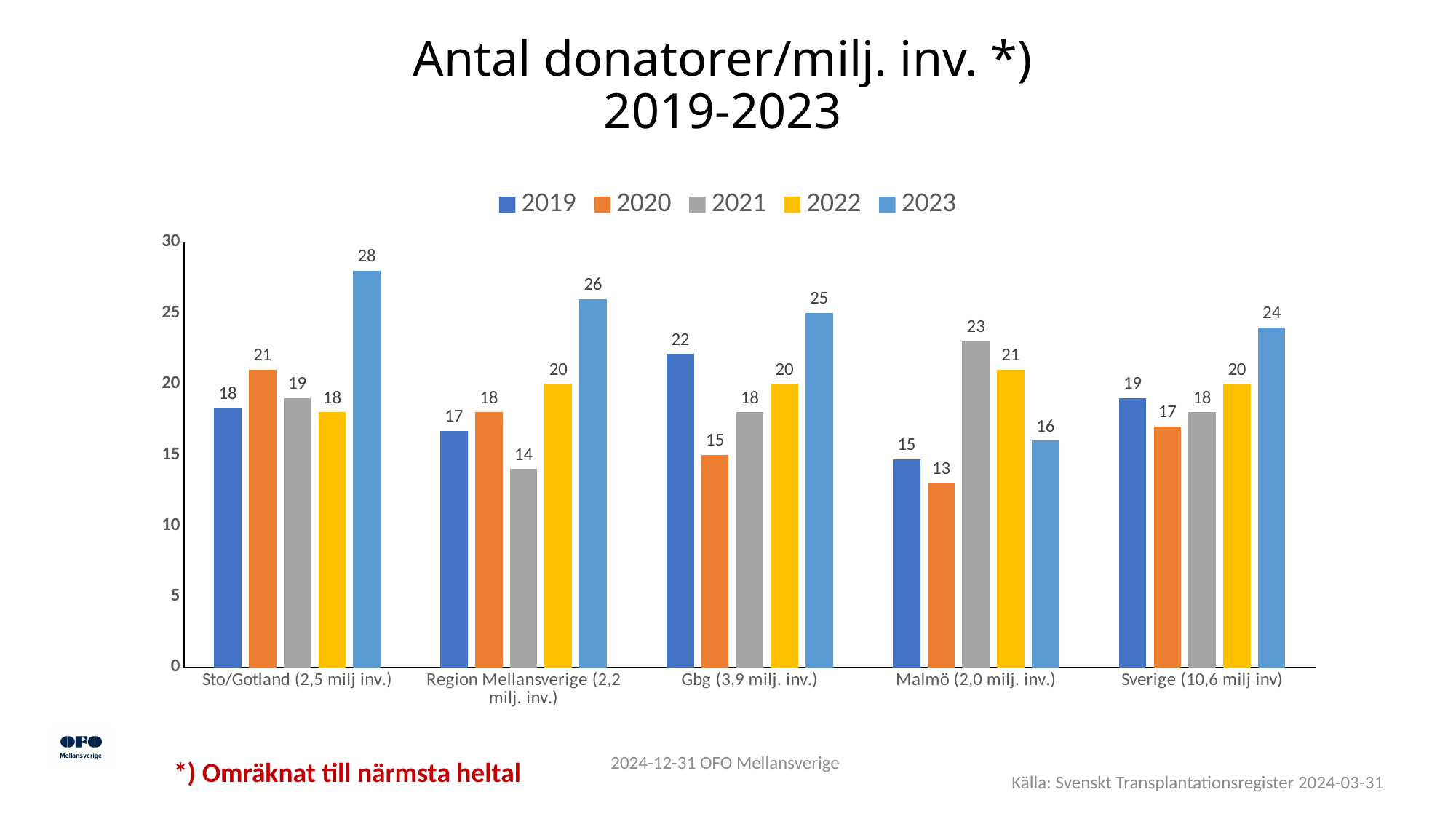
How many series does the legend list? 5 What is the title of the chart? Antal donatorer/milj. inv. *) 2019-2023 Which is larger for Gbg: the 2019 value or the 2020 value? 2019 What kind of chart is shown on the slide? Bar chart What is the difference between the 2023 and 2019 values for Region Mellansverige? 9 Is the 2021 value for Region Mellansverige greater or less than 15? less Which region has the lowest value in 2020? Malmö (2,0 milj. inv.) What is the value for Sverige in 2020? 17 What is the value for Sto/Gotland in 2023? 28 Which region has the highest value in 2023? Sto/Gotland (2,5 milj inv.) What is the value for Malmö in 2021? 23 How many regions (categories) are shown on the x axis? 5